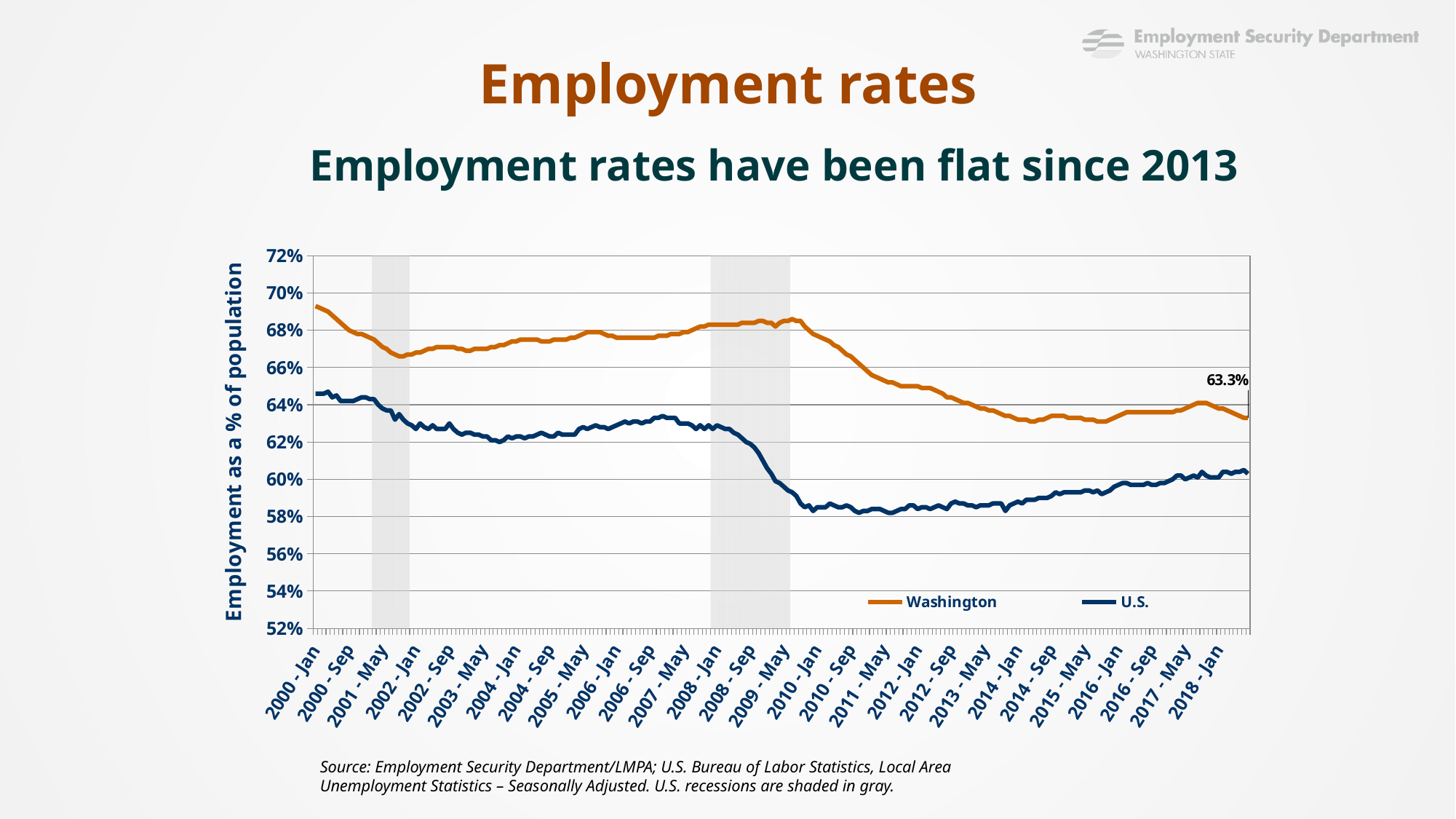
Does the U.S. line rise or fall between 2008 - Sep and 2010 - Jan? fall Is the Washington employment rate in 2000 - Jan greater or less than 68%? greater Which series is higher throughout the chart, Washington or U.S.? Washington Which series has the higher employment rate in 2000 - Jan, Washington or U.S.? Washington Does the Washington line rise or fall between 2009 - May and 2014 - Jan? fall What kind of chart is shown on the slide? line chart What is the labelled value at the end of the Washington line? 63.3% Is the Washington employment rate in 2018 - Jan greater or less than 66%? less How many series does the legend list? 2 What do the gray shaded areas on the chart represent? U.S. recessions What is the title of the vertical axis? Employment as a % of population Is the U.S. employment rate in 2011 - May greater or less than 60%? less